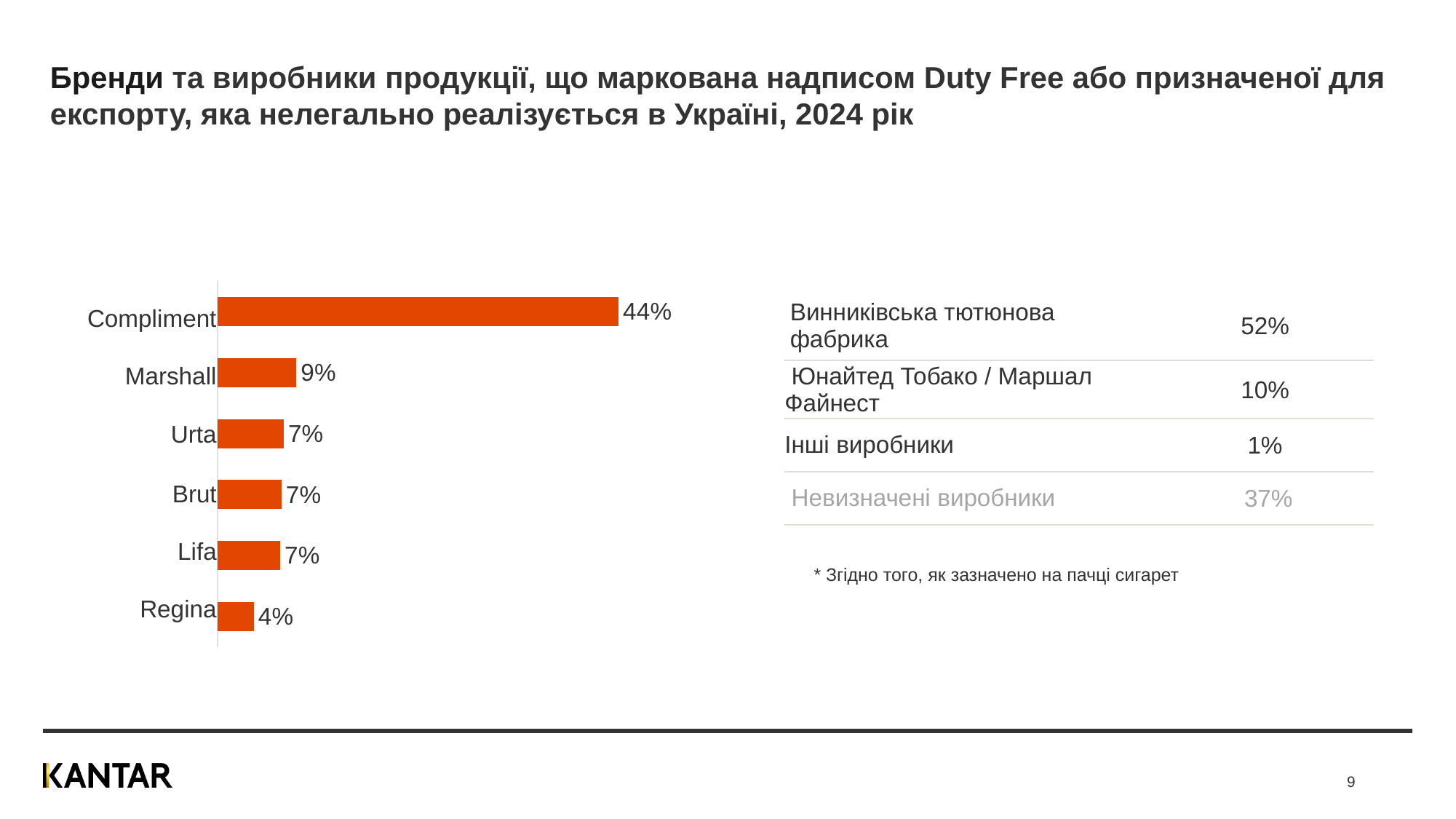
How many brands are shown in the bar chart? 6 What is the difference between the values for Compliment and Marshall? 35% What colour are the bars in the chart? Orange Which is larger in the bar chart, the value for Marshall or the value for Lifa? Marshall What is the value for Marshall in the bar chart? 9% What is the value for Compliment in the bar chart? 44% Which brand has the highest value in the bar chart? Compliment What kind of chart is shown on the slide? Bar chart What is the value for Regina in the bar chart? 4% Which brand has the lowest value in the bar chart? Regina What is the difference between the values for Marshall and Regina? 5% What is the value for Urta in the bar chart? 7%